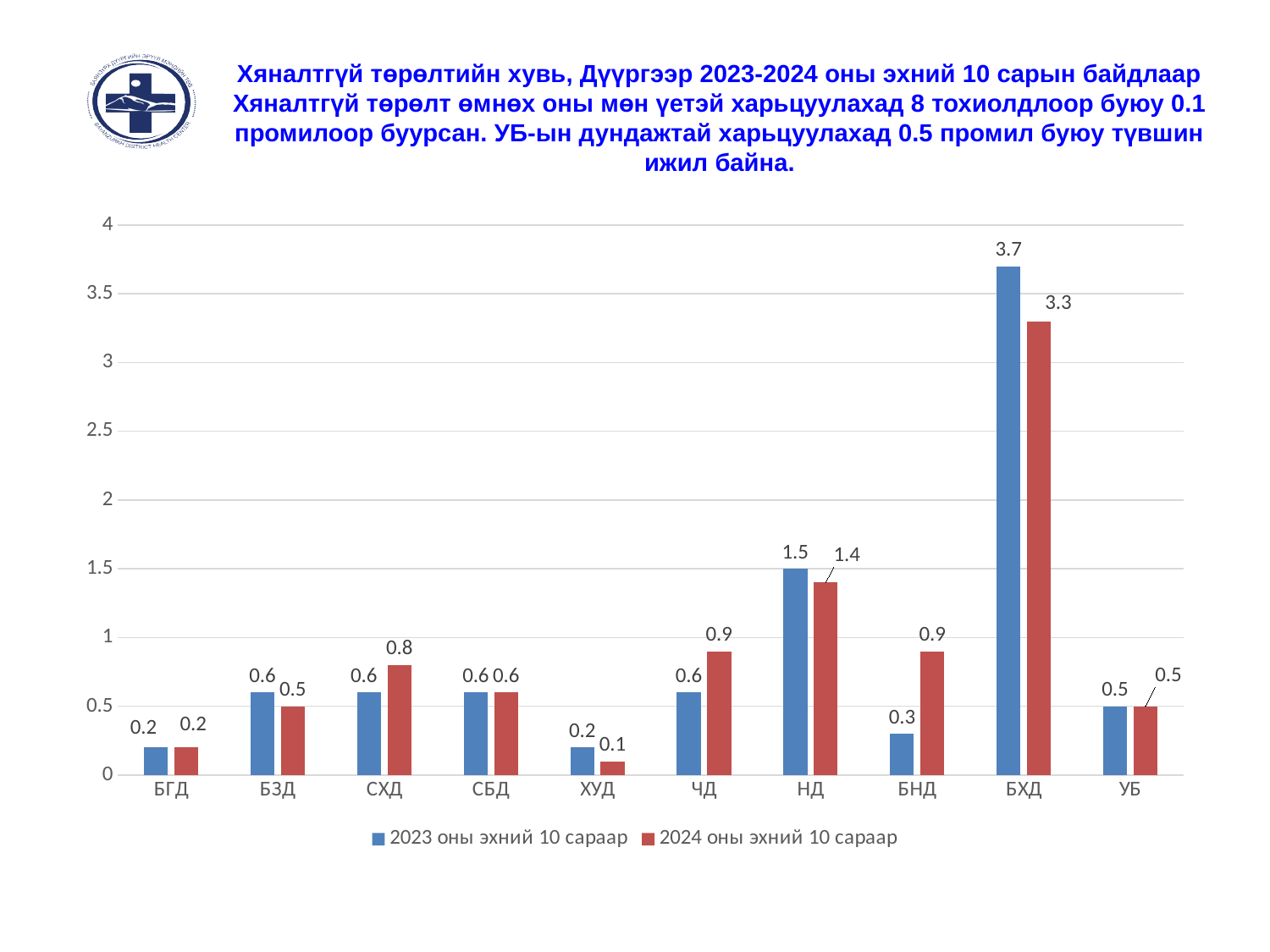
What is the difference between the 2023 and 2024 values for БХД? 0.4 What is the value for НД in the 2024 оны эхний 10 сараар series? 1.4 What is the value for БХД in the 2023 оны эхний 10 сараар series? 3.7 What is the value for БНД in the 2024 оны эхний 10 сараар series? 0.9 Which is larger for ЧД: the 2023 оны эхний 10 сараар value or the 2024 оны эхний 10 сараар value? 2024 оны эхний 10 сараар How many categories are shown on the x axis? 10 Is the 2023 value for НД greater or less than 1? greater Which category has the highest value in the 2023 оны эхний 10 сараар series? БХД How many series does the legend list? 2 What is the difference between the 2024 and 2023 values for БНД? 0.6 Which category has the lowest value in the 2024 оны эхний 10 сараар series? ХУД What kind of chart is shown on the slide? Bar chart